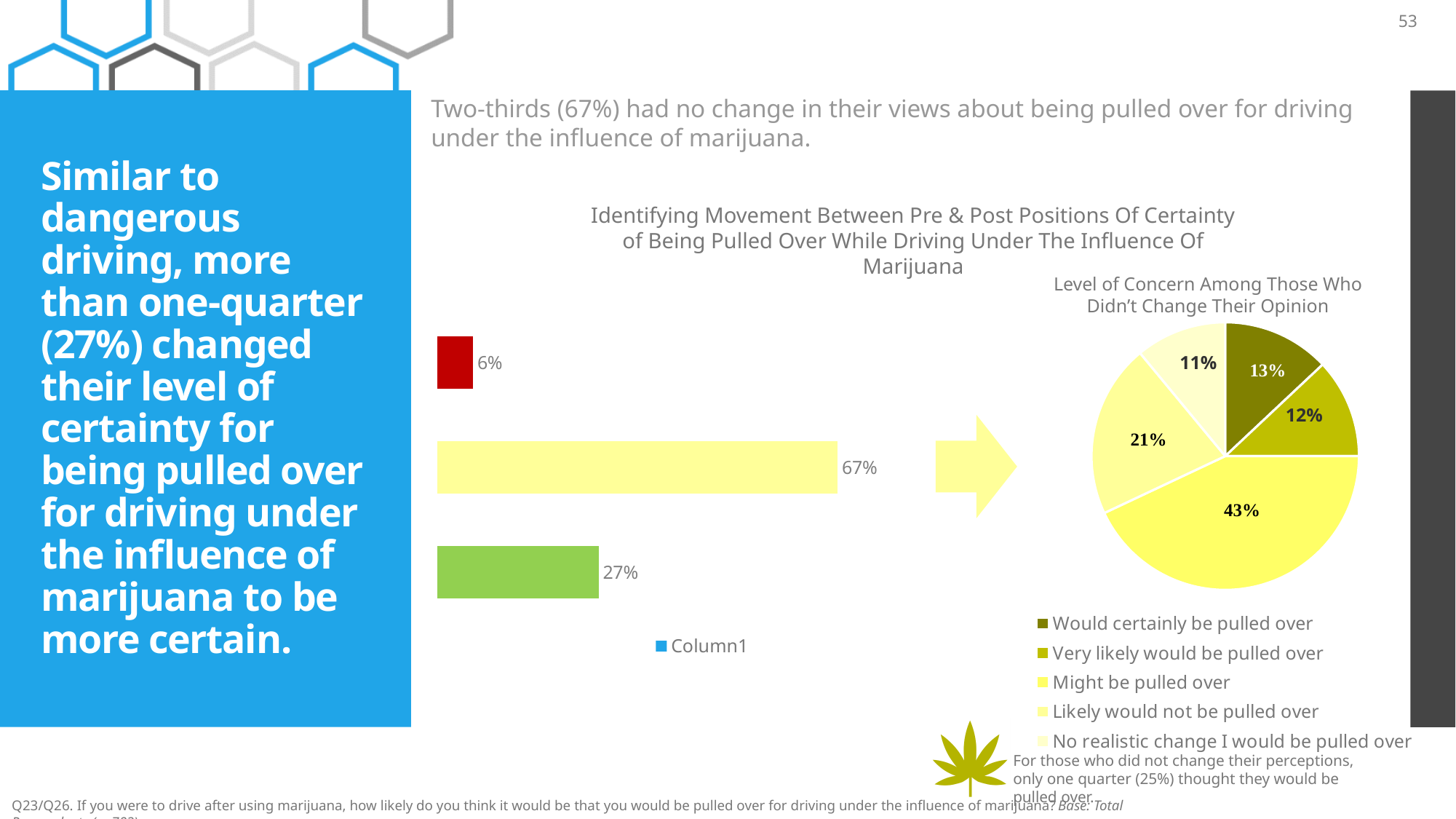
In the pie chart 'Level of Concern Among Those Who Didn't Change Their Opinion', which is larger: 'Likely would not be pulled over' or 'Very likely would be pulled over'? Likely would not be pulled over In the pie chart 'Level of Concern Among Those Who Didn't Change Their Opinion', what share is 'Might be pulled over'? 43% In the bar chart on the left, what is the difference between the yellow bar (67%) and the green bar (27%)? 40% In the bar chart on the left, what value is shown on the green bar? 27% In the pie chart 'Level of Concern Among Those Who Didn't Change Their Opinion', which category has the largest slice? Might be pulled over How many bars are plotted in the bar chart on the left? 3 In the bar chart on the left, what is the value of the shortest bar? 6% What kind of chart is the chart on the left of the slide? Bar chart In the pie chart 'Level of Concern Among Those Who Didn't Change Their Opinion', what share is 'Would certainly be pulled over'? 13% How many entries does the legend of the pie chart 'Level of Concern Among Those Who Didn't Change Their Opinion' list? 5 In the bar chart titled 'Identifying Movement Between Pre & Post Positions Of Certainty of Being Pulled Over While Driving Under The Influence Of Marijuana', what is the value of the longest bar? 67% In the pie chart 'Level of Concern Among Those Who Didn't Change Their Opinion', which category has the smallest slice? No realistic change I would be pulled over